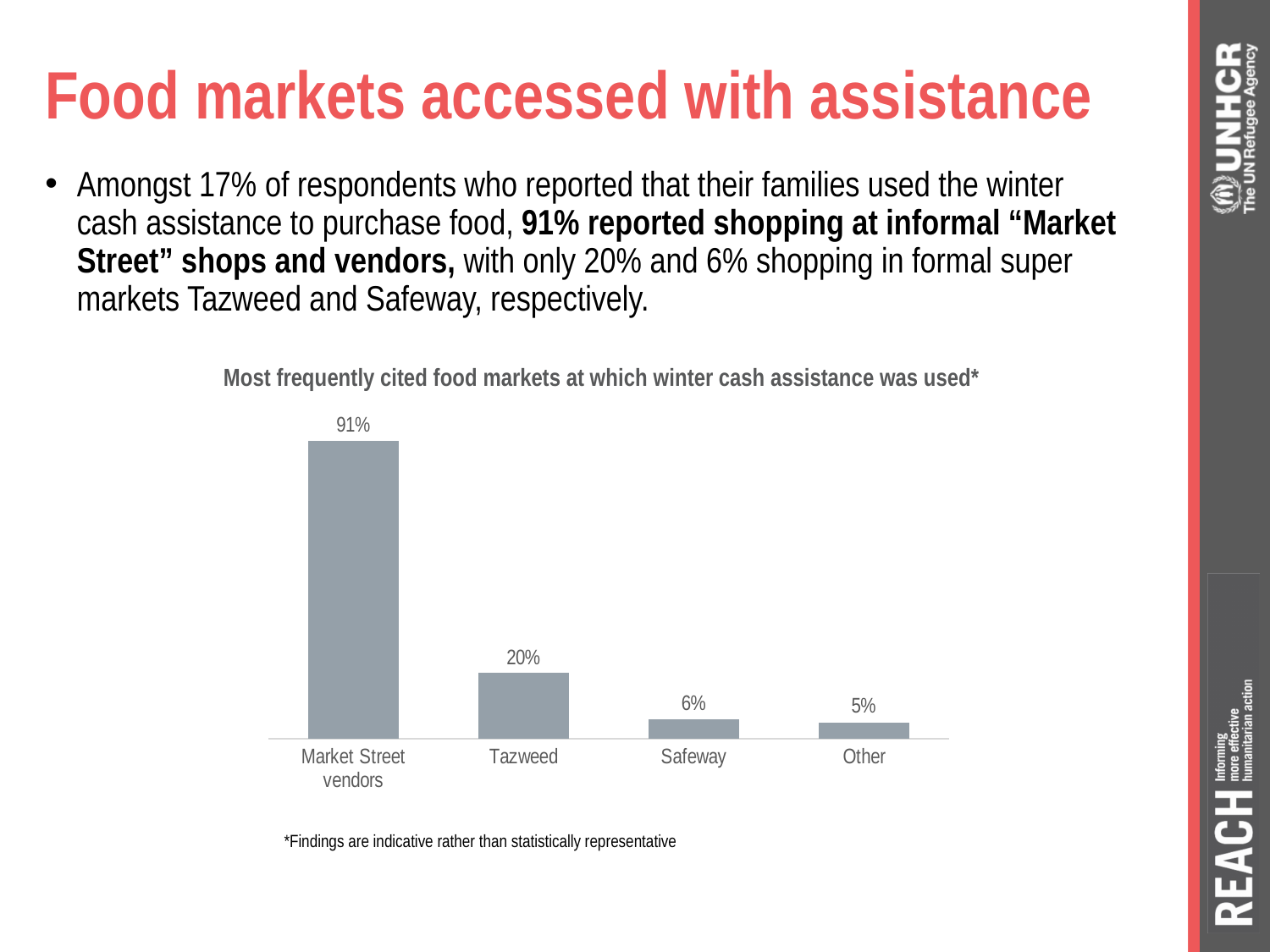
What kind of chart is shown on the slide? Bar chart What is the title of the chart? Most frequently cited food markets at which winter cash assistance was used* How many categories are shown in the chart? 4 What is the difference between the values for Tazweed and Safeway? 14% What percentage is shown for Tazweed? 20% What percentage is shown for Other? 5% Which has a larger value, Tazweed or Safeway? Tazweed What percentage is shown for Safeway? 6% Which category has the lowest value? Other Which food market has the highest value? Market Street vendors What percentage is shown for Market Street vendors? 91% What is the difference between the values for Market Street vendors and Tazweed? 71%